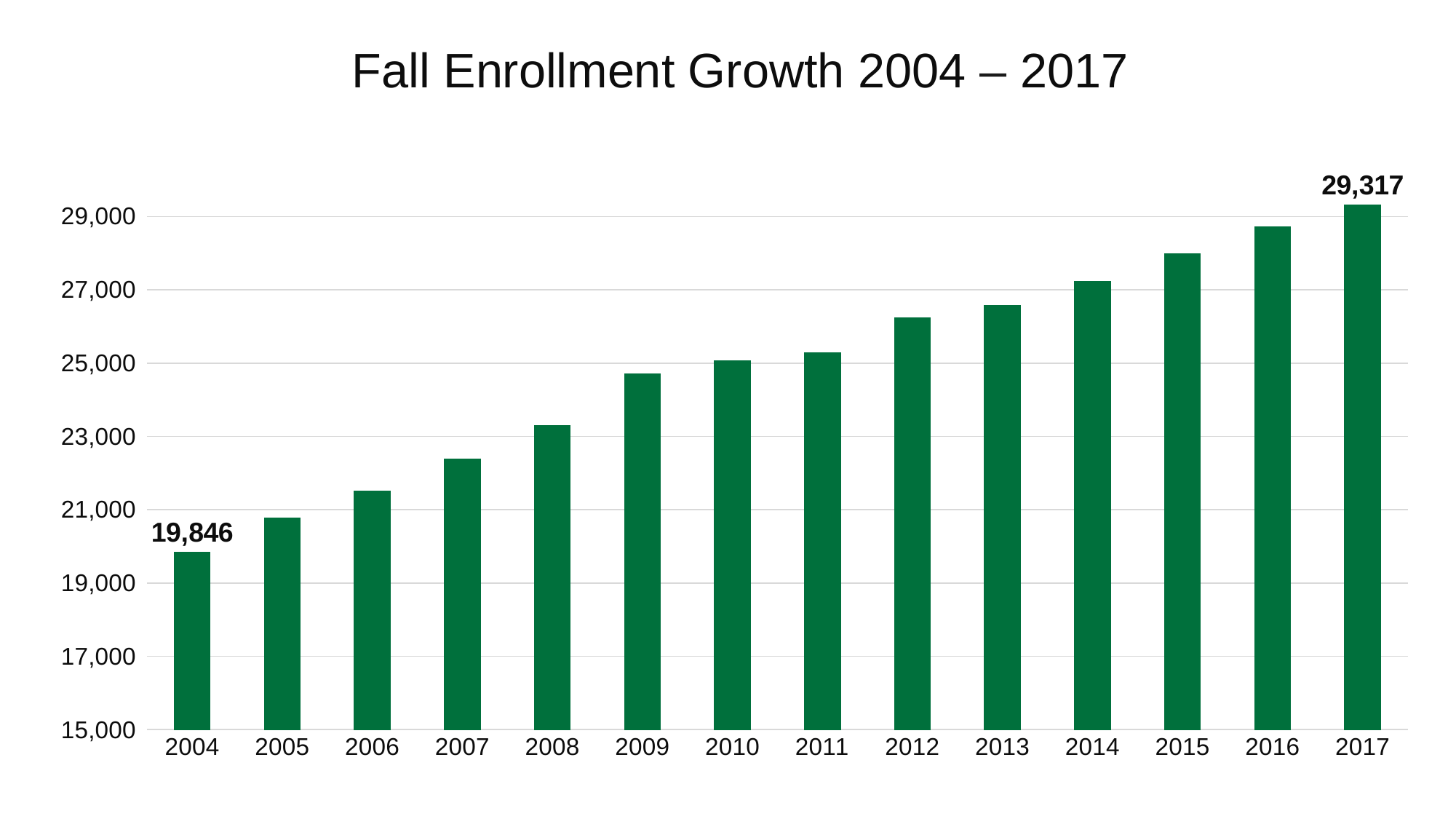
Is the value for 2007 greater or less than 23,000? less Which year has the larger enrollment, 2008 or 2012? 2012 What is the difference between the 2017 and 2004 enrollment values? 9,471 Do the enrollment values rise or fall from 2004 to 2017? Rise Which year has the highest fall enrollment? 2017 How many years are shown on the x axis? 14 What kind of chart is shown on the slide? Bar chart Is the value for 2015 greater or less than 27,000? greater What is the fall enrollment value shown for 2004? 19,846 Which year has the lowest fall enrollment? 2004 What is the fall enrollment value shown for 2017? 29,317